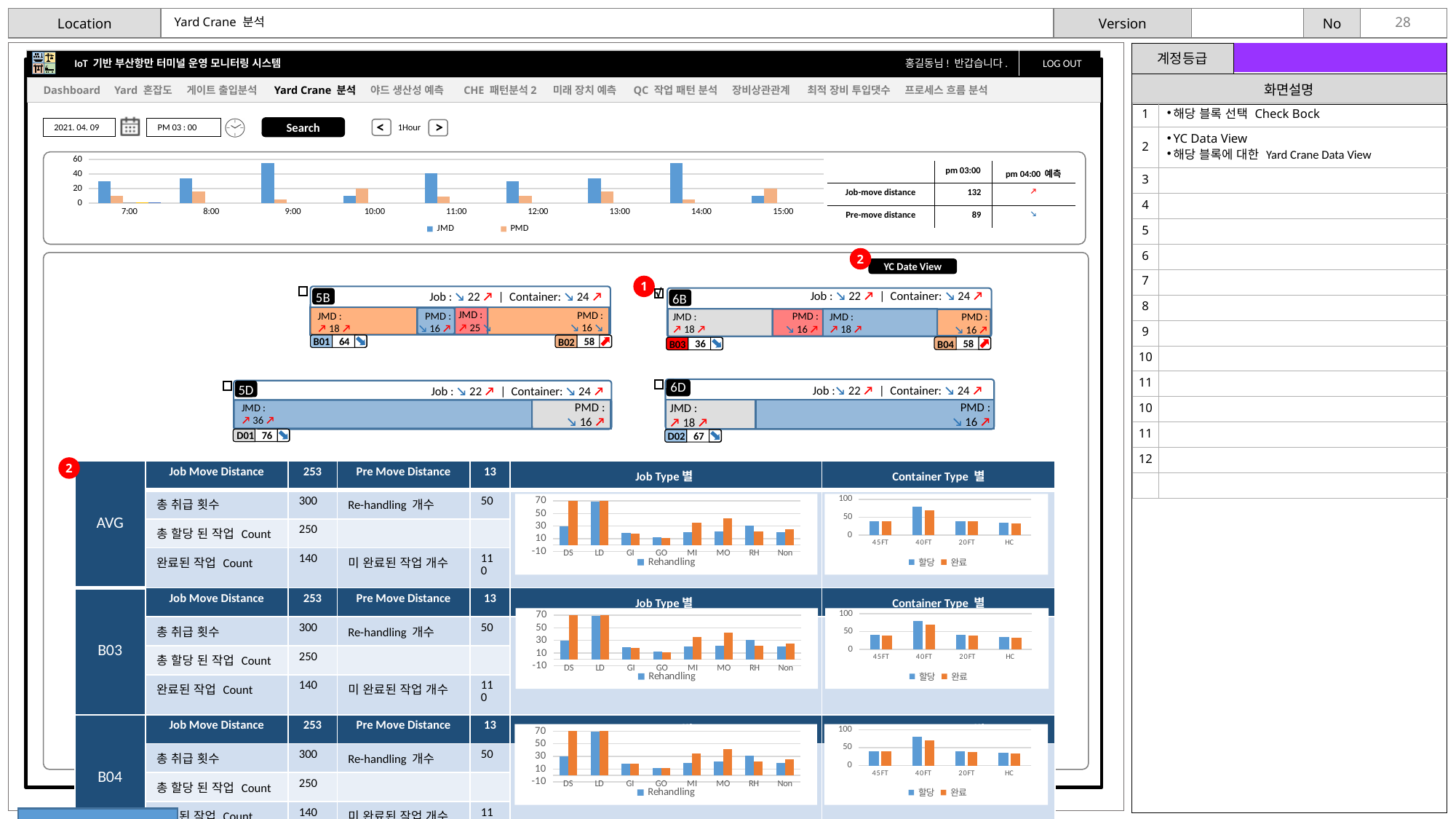
How many time categories are shown on the x axis of the top JMD/PMD chart? 9 In the top JMD/PMD chart, is the PMD value at 9:00 greater or less than 20? less In the 'Job Type 별' chart in the AVG row, is the value for GO greater or less than 30? less In the top JMD/PMD chart, which is larger at 10:00, JMD or PMD? PMD In the top JMD/PMD chart, is the JMD value at 9:00 greater or less than 40? greater In the 'Job Type 별' chart in the AVG row, which category has the lowest values? GO In the top JMD/PMD chart, which is larger at 7:00, JMD or PMD? JMD In the 'Job Type 별' chart in the AVG row, how many categories are on the x axis? 8 In the 'Container Type 별' chart in the AVG row, which category has the highest values? 40FT How many series does the legend of the top JMD/PMD chart list? 2 What are the two legend entries of the 'Container Type 별' chart in the AVG row? 할당, 완료 What kind of chart is the top chart showing JMD and PMD by hour? bar chart